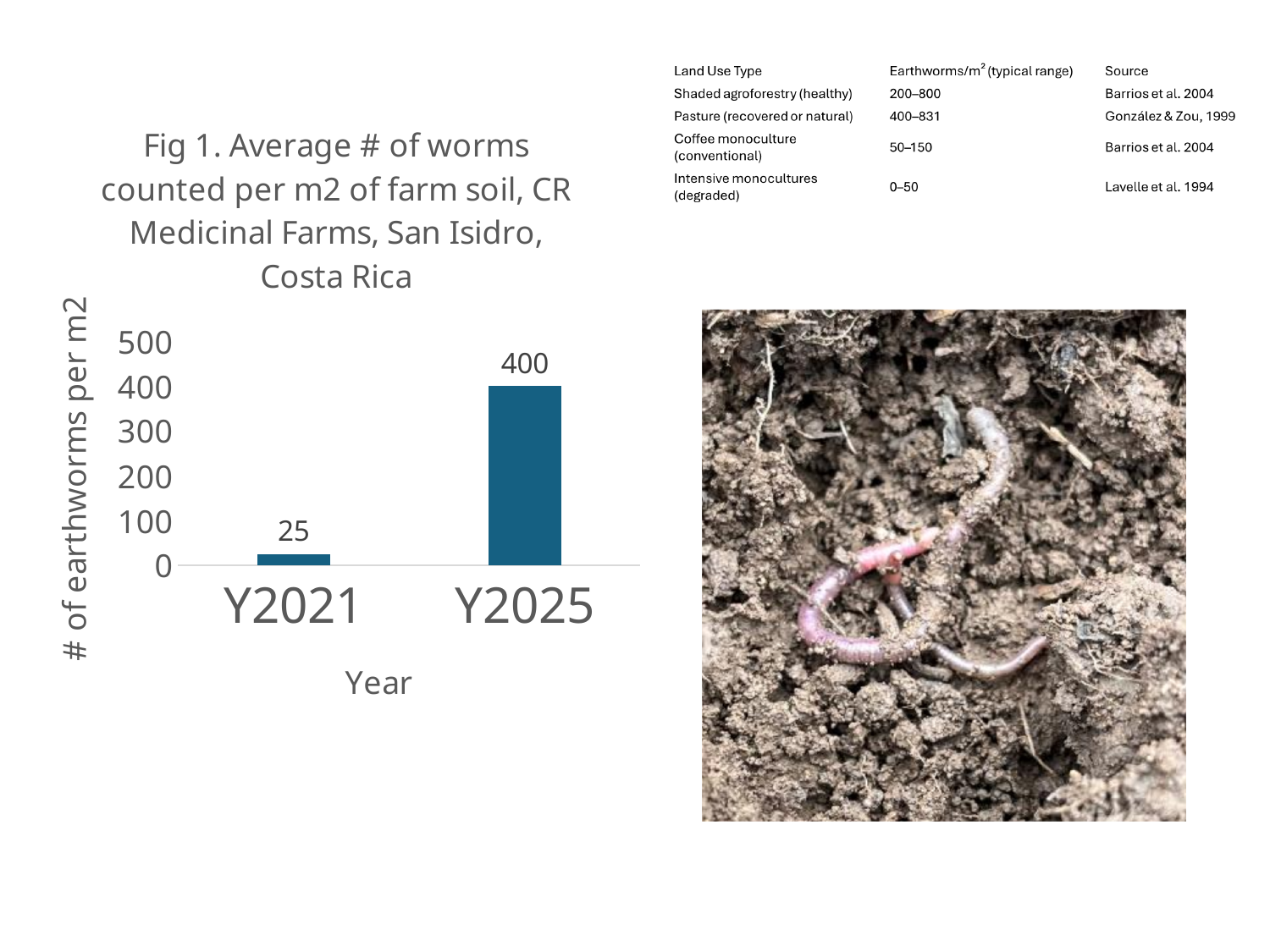
Which year has the highest number of earthworms per m2? Y2025 What is the label of the x axis? Year What is the value for Y2021? 25 Do the values rise or fall from Y2021 to Y2025? rise Is the value for Y2021 greater or less than 100? less How many years are shown on the chart? 2 Which year has the lowest number of earthworms per m2? Y2021 Is the value for Y2025 greater or less than 300? greater Which is larger, the value for Y2021 or the value for Y2025? Y2025 What kind of chart is shown? bar chart What is the value for Y2025? 400 What is the difference between the values for Y2025 and Y2021? 375